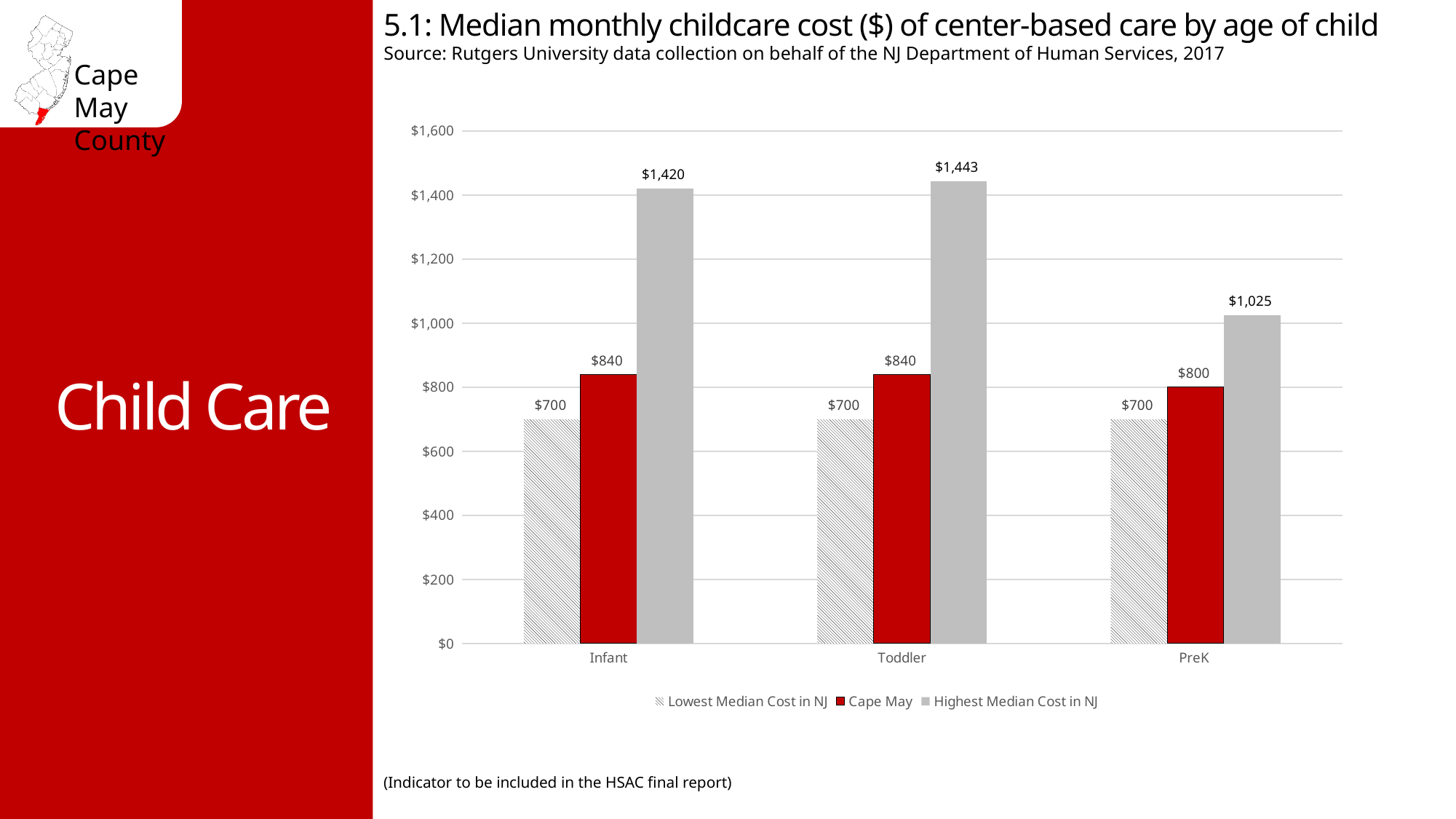
Which age group has the highest value for the Highest Median Cost in NJ series? Toddler What is the Cape May median monthly childcare cost for Infant care? $840 What is the Lowest Median Cost in NJ for PreK care? $700 What is the Cape May median monthly cost for PreK care? $800 What is the Highest Median Cost in NJ for Toddler care? $1,443 Which is larger for PreK care: the Cape May cost or the Lowest Median Cost in NJ? Cape May What is the difference between the Highest Median Cost in NJ and the Cape May cost for Infant care? $580 What kind of chart is shown on the slide? Bar chart How many age groups are shown on the x axis? 3 Which age group has the lowest Cape May median monthly cost? PreK Which series is shown in red? Cape May How many series does the legend list? 3